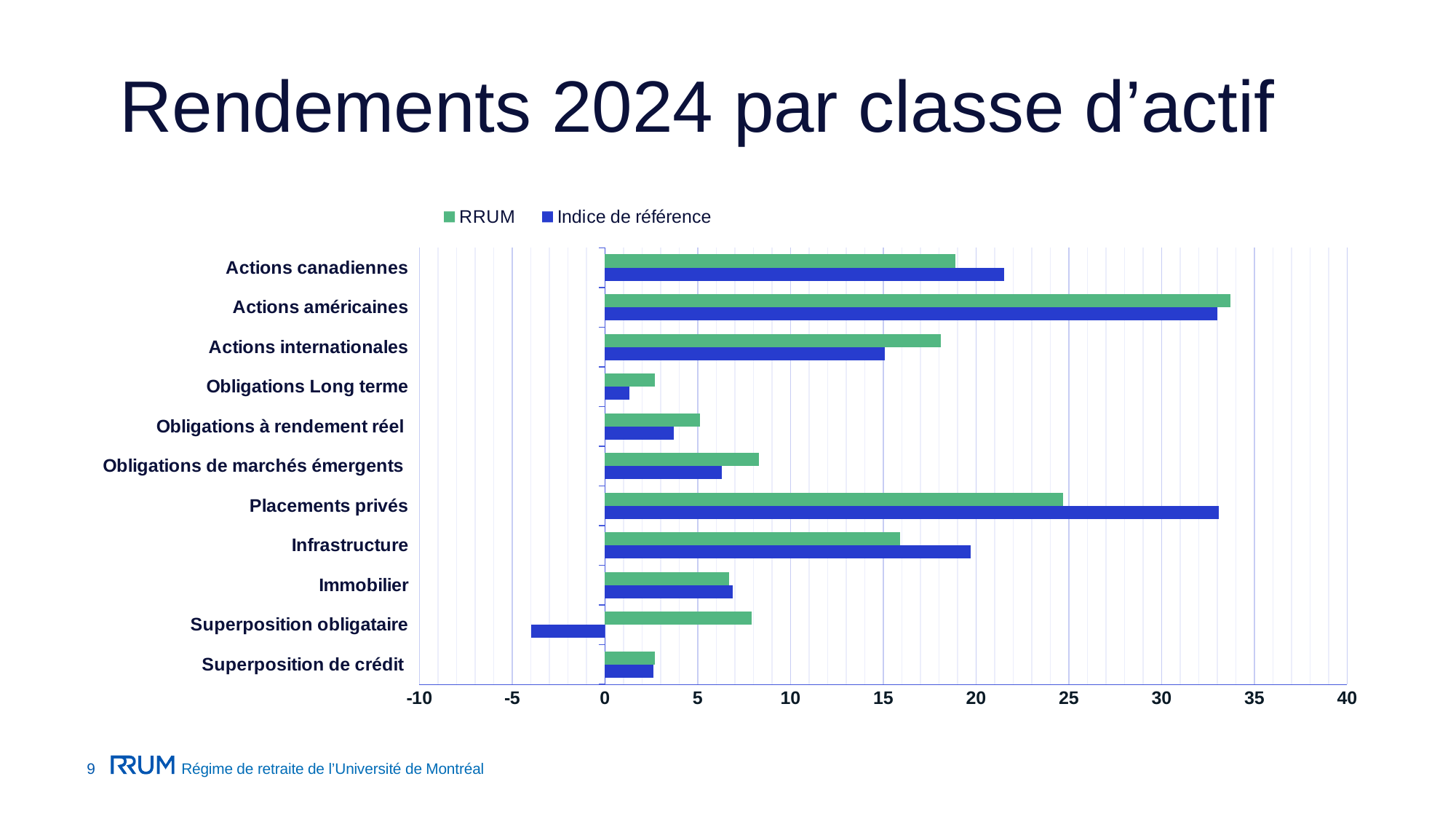
How many series does the legend list? 2 Is the Indice de référence value for Superposition obligataire greater or less than 0? less Which asset class has the lowest Indice de référence value? Superposition obligataire Is the Indice de référence value for Placements privés greater or less than 30? greater What kind of chart is shown on the slide? bar chart Which asset class has the highest RRUM return? Actions américaines Is the RRUM value for Actions internationales greater or less than 15? greater What is the title of the chart slide? Rendements 2024 par classe d’actif How many asset classes (categories) are shown on the chart? 11 For Actions internationales, which is larger: RRUM or Indice de référence? RRUM For Placements privés, which is larger: RRUM or Indice de référence? Indice de référence